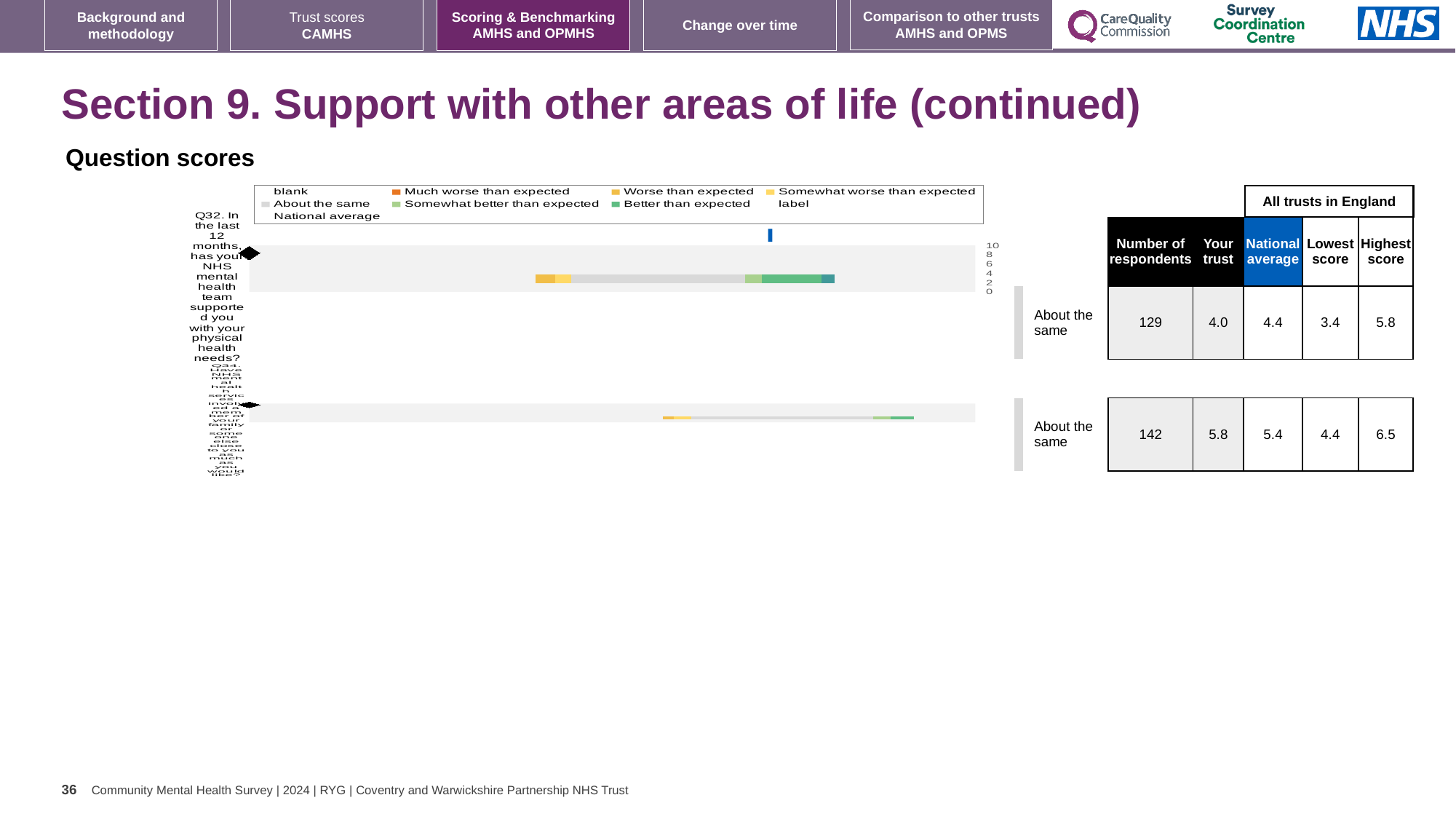
Which legend entry is shown in dark orange? Much worse than expected What is the difference between the highest score and the lowest score for Q32? 2.4 What is the highest value shown on the chart's axis? 10 Which question has the larger 'Your trust' score, Q32 or Q34? Q34 What is the 'Your trust' score for Q34 (involving family or someone close)? 5.8 What is the difference between the 'Your trust' score and the national average for Q34? 0.4 How many questions (bars) are plotted in the chart? 2 What is the highest score across all trusts in England for Q34? 6.5 What is the number of respondents for Q34? 142 What is the national average for Q32? 4.4 What is the 'Your trust' score for Q32 (support with physical health needs)? 4.0 What kind of chart is shown under 'Question scores'? bar chart